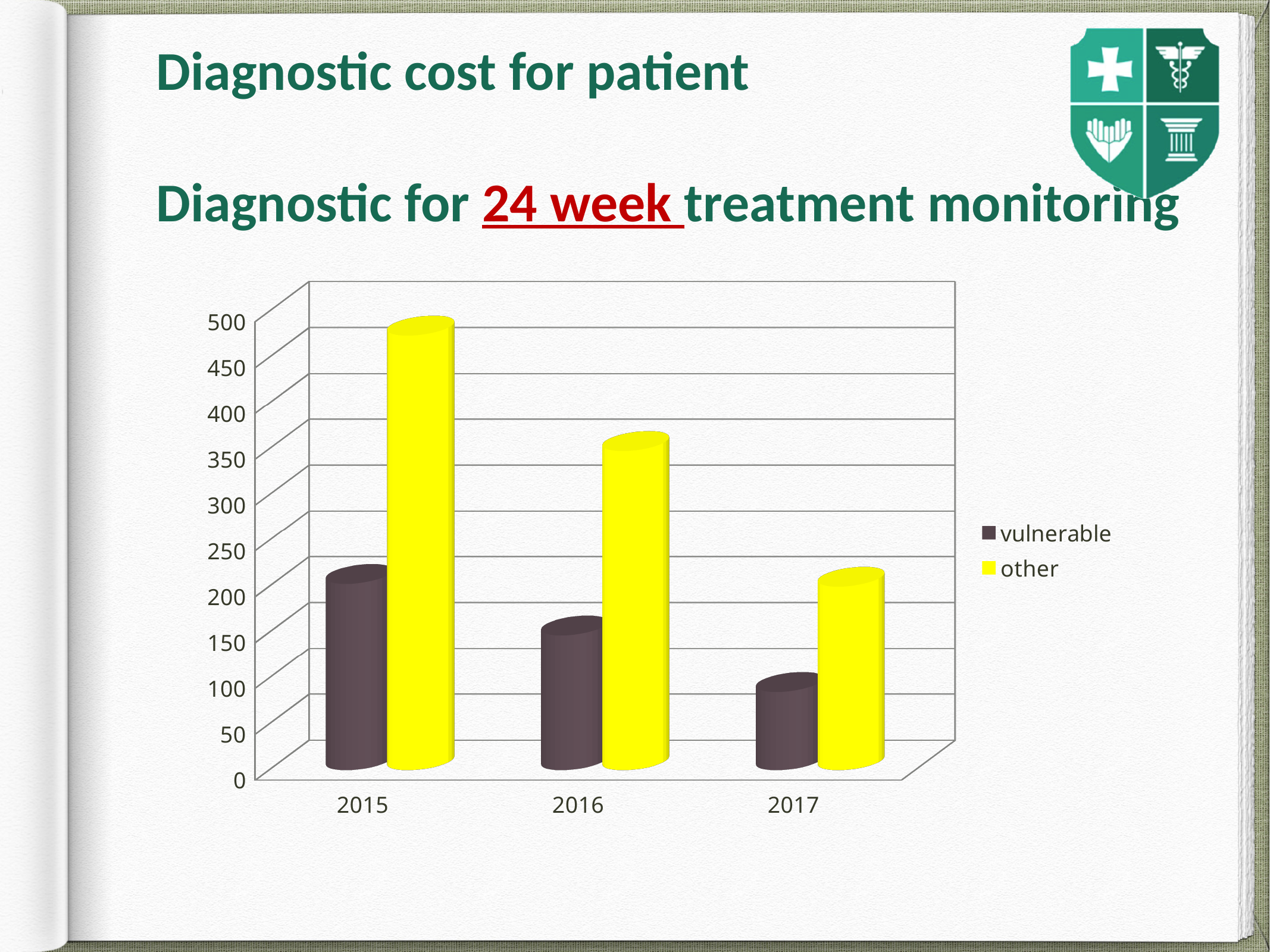
What kind of chart is shown on the slide? bar chart How many series does the legend list? 2 In 2016, which series has the larger value, 'vulnerable' or 'other'? other What are the two series named in the legend? vulnerable and other Which year has the lowest value for the 'vulnerable' series? 2017 What colour are the bars for the 'other' series? yellow How many years are shown on the x axis? 3 Which year has the highest value for the 'other' series? 2015 Is the value for 'vulnerable' in 2017 greater or less than 150? less Is the value for 'other' in 2017 greater or less than 300? less Do the values for the 'vulnerable' series rise or fall from 2015 to 2017? fall Is the value for 'other' in 2015 greater or less than 400? greater